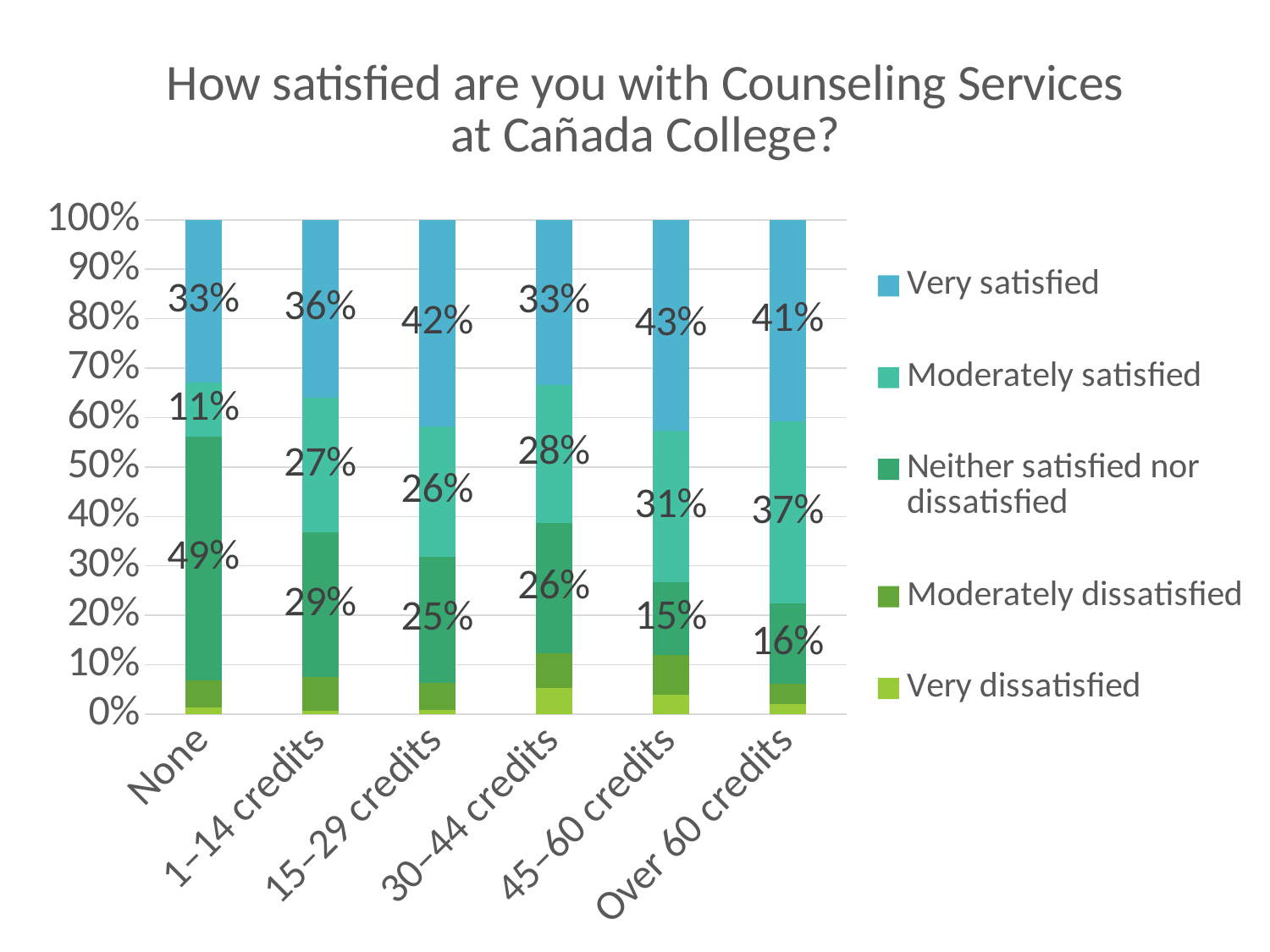
Which credit group has the lowest 'Moderately satisfied' percentage? None How many credit groups are shown on the x axis? 6 What is the difference between the 'Very satisfied' percentages for 15–29 credits and 1–14 credits? 6% Which is larger: the 'Moderately satisfied' value for 30–44 credits or for 45–60 credits? 45–60 credits Which credit group has the highest 'Very satisfied' percentage? 45–60 credits Which credit group has the highest 'Neither satisfied nor dissatisfied' percentage? None What percentage of respondents with no credits were very satisfied with Counseling Services? 33% How many series does the legend list? 5 What is the 'Very satisfied' value for the 45–60 credits group? 43% What kind of chart is shown on the slide? Stacked bar chart What percentage of respondents with over 60 credits were moderately satisfied? 37% What is the 'Neither satisfied nor dissatisfied' value for the 'None' credits group? 49%